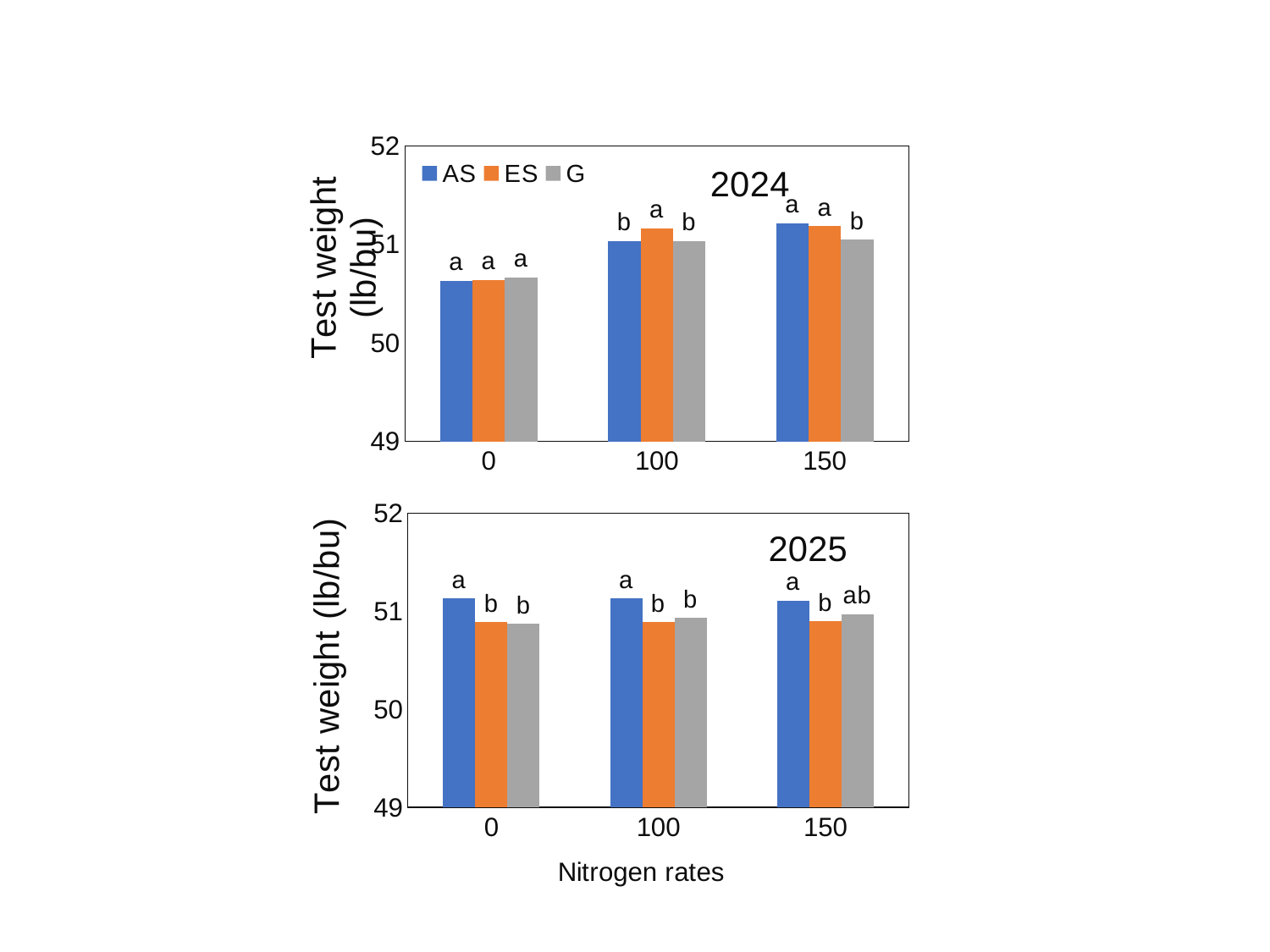
In the 2025 chart, which series has the highest value at nitrogen rate 0? AS In the 2025 chart, is the value for ES at nitrogen rate 0 greater or less than 51? less How many nitrogen rate categories are shown on the x axis of the 2025 chart? 3 What is the x-axis title shown below the 2025 chart? Nitrogen rates In the 2024 chart, do the AS values rise or fall as the nitrogen rate increases from 0 to 150? rise What are the legend entries in the 2024 chart? AS, ES, G How many series does the legend of the 2024 chart list? 3 In the 2025 chart, is the value for AS at nitrogen rate 100 greater or less than 51? greater What kind of chart is the 2024 chart? bar chart In the 2024 chart, is the value for AS at nitrogen rate 150 greater or less than 51? greater In the 2025 chart, at nitrogen rate 150, which is larger: AS or ES? AS